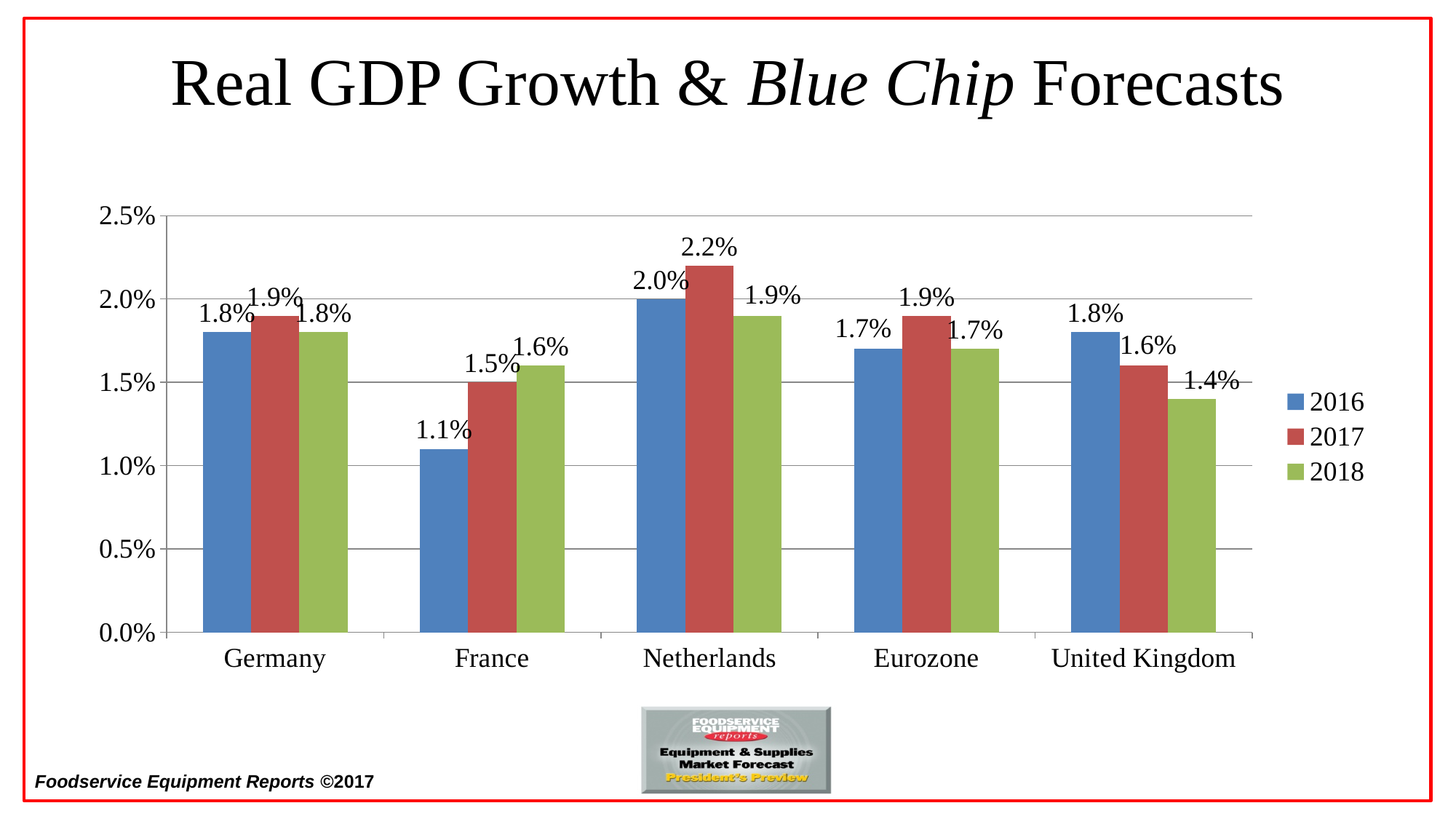
What is the 2016 value for France? 1.1% Is the 2016 value for the Netherlands greater or less than 1.5%? greater Which country or region has the highest 2017 value? Netherlands What kind of chart is shown on the slide? bar chart Do the values for the United Kingdom rise or fall from 2016 to 2018? fall How many series does the legend list? 3 Which country or region has the lowest 2016 value? France What is the difference between the 2017 and 2016 values for France? 0.4% Which is larger for the United Kingdom, the 2016 value or the 2018 value? 2016 What is the 2017 value for the Netherlands? 2.2% What is the 2018 value for the United Kingdom? 1.4% How many countries or regions are shown on the x axis? 5